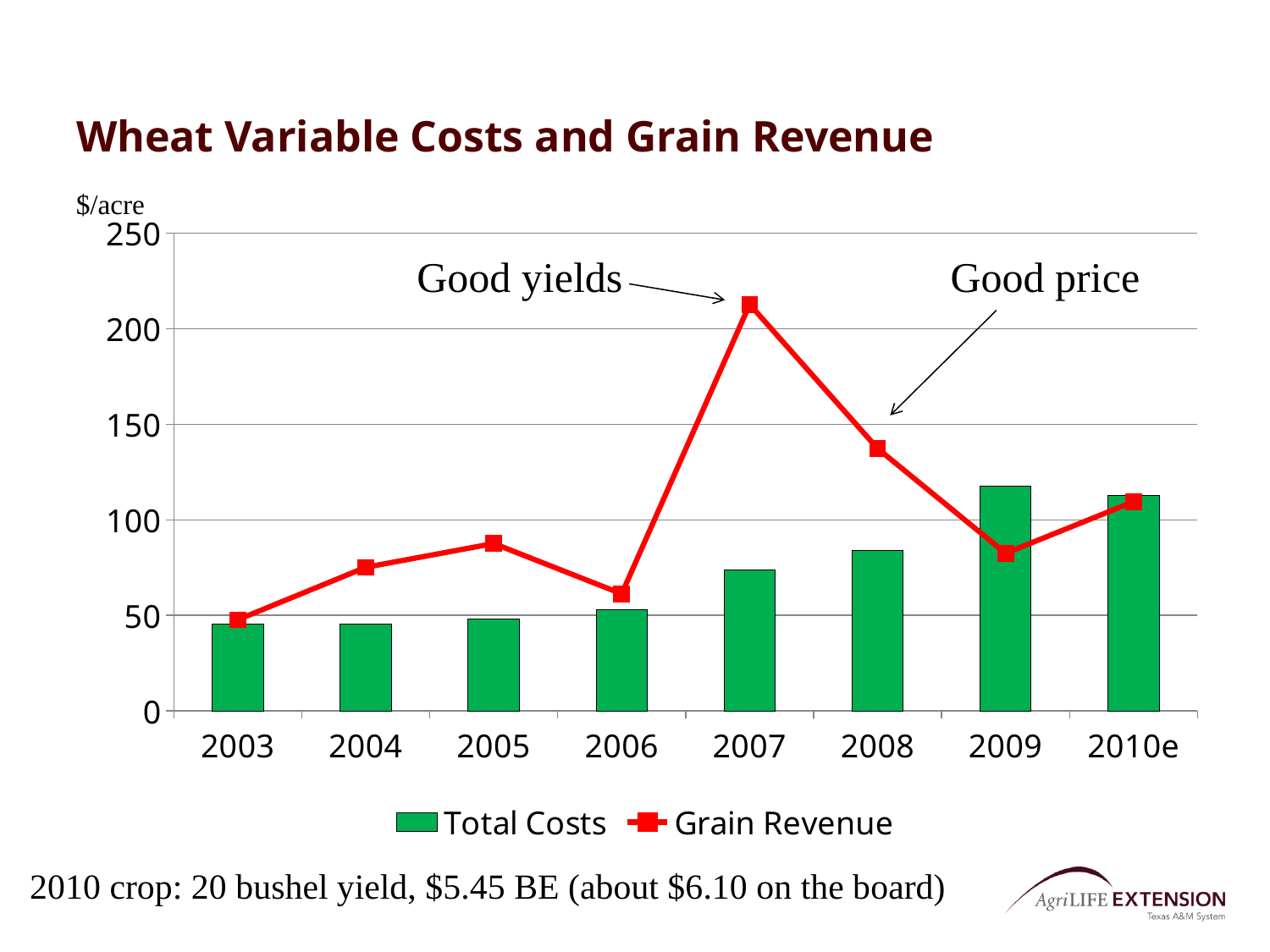
Is the Total Costs value for 2009 greater or less than 100? greater What unit is shown on the y axis? $/acre In 2008, which is larger: Total Costs or Grain Revenue? Grain Revenue How many years are shown on the x axis? 8 In which year is Grain Revenue lowest? 2003 What kind of chart is shown on the slide? A combined bar and line chart Is the Grain Revenue value for 2006 greater or less than 100? less In 2009, which is larger: Total Costs or Grain Revenue? Total Costs In which year is Grain Revenue highest? 2007 How many series does the legend list? 2 Is the Grain Revenue value for 2007 greater or less than 200? greater In which year are Total Costs highest? 2009